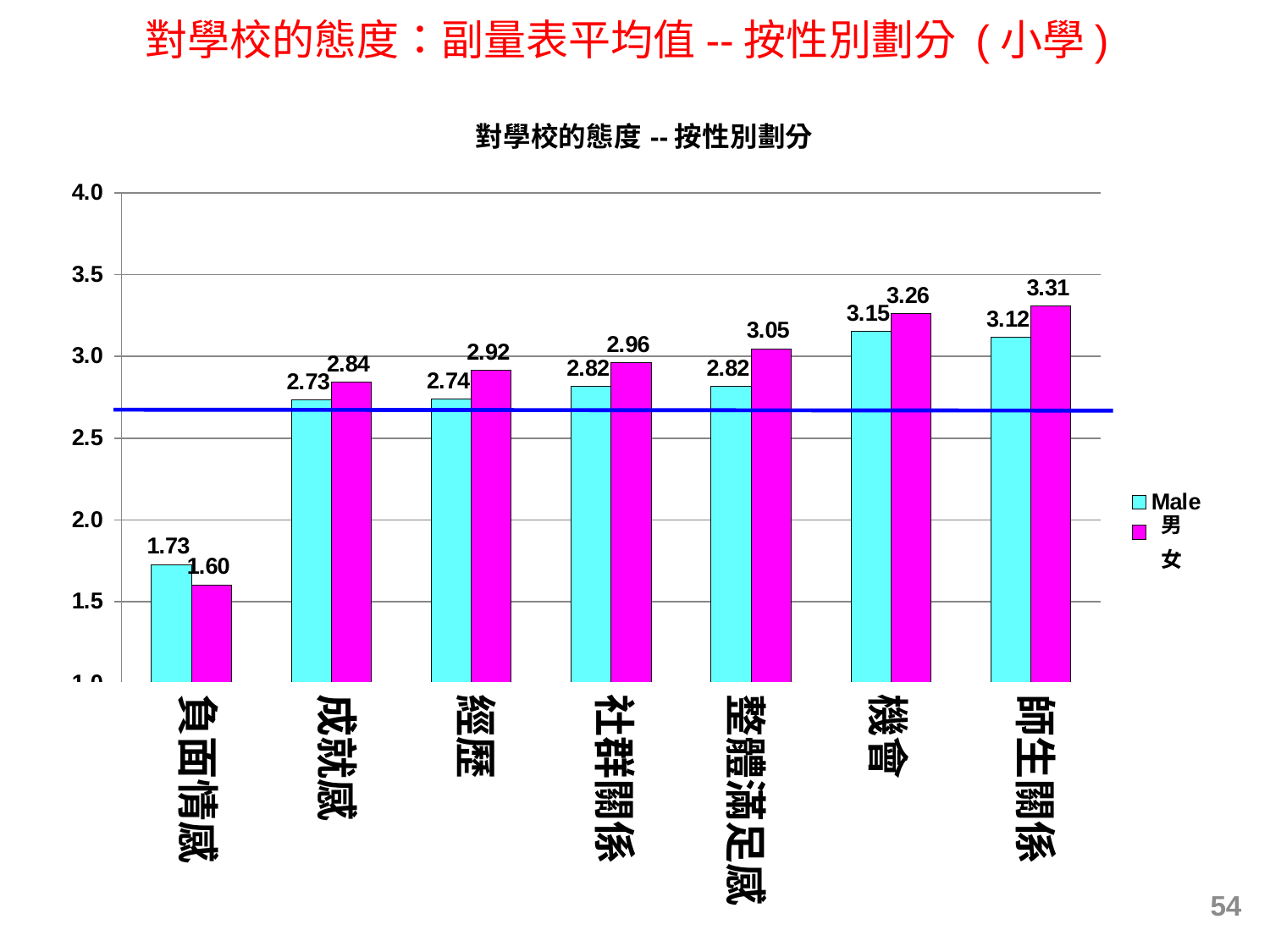
Is the value for Male 男 in the 機會 category greater or less than 3.0? greater What is the value for 女 in the 師生關係 category? 3.31 What is the difference between the 女 and Male 男 values in the 師生關係 category? 0.19 In the 負面情感 category, which is larger: the Male 男 value or the 女 value? Male 男 How many series does the legend list? 2 What is the title of the chart? 對學校的態度 -- 按性別劃分 Which category has the highest value for the 女 series? 師生關係 How many categories are shown on the x axis? 7 What kind of chart is shown on the slide? bar chart What is the value for Male 男 in the 負面情感 category? 1.73 What is the value for 女 in the 整體滿足感 category? 3.05 Which category has the lowest value for the Male 男 series? 負面情感